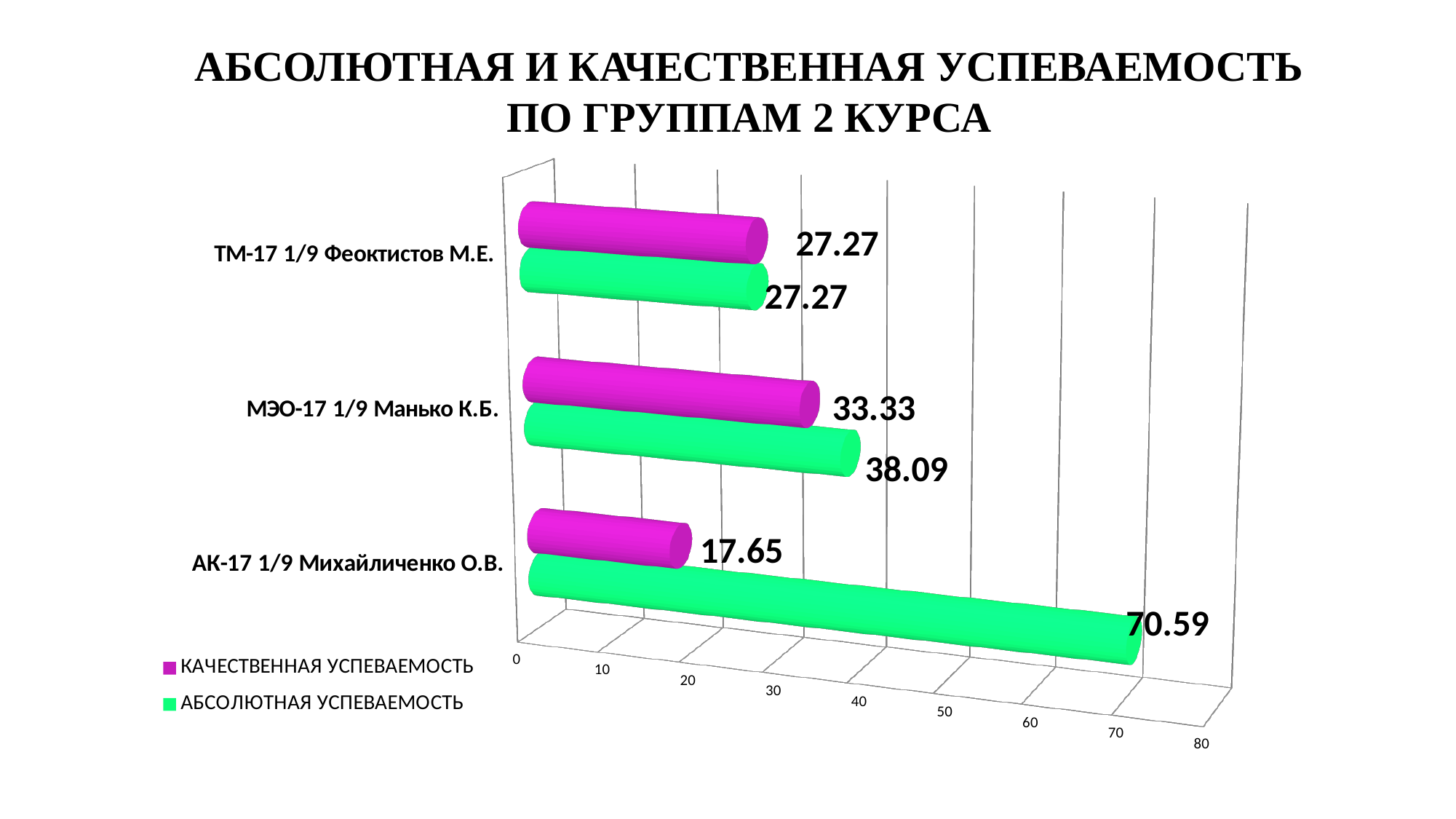
What is the difference between АБСОЛЮТНАЯ УСПЕВАЕМОСТЬ and КАЧЕСТВЕННАЯ УСПЕВАЕМОСТЬ for АК-17 1/9 Михайличенко О.В.? 52.94 How many series does the legend list? 2 Is the АБСОЛЮТНАЯ УСПЕВАЕМОСТЬ value for АК-17 1/9 Михайличенко О.В. greater or less than 60? greater What is the АБСОЛЮТНАЯ УСПЕВАЕМОСТЬ value for ТМ-17 1/9 Феоктистов М.Е.? 27.27 How many groups are shown on the chart? 3 What is the КАЧЕСТВЕННАЯ УСПЕВАЕМОСТЬ value for АК-17 1/9 Михайличенко О.В.? 17.65 Which is larger for МЭО-17 1/9 Манько К.Б.: АБСОЛЮТНАЯ УСПЕВАЕМОСТЬ or КАЧЕСТВЕННАЯ УСПЕВАЕМОСТЬ? АБСОЛЮТНАЯ УСПЕВАЕМОСТЬ Which group has the highest АБСОЛЮТНАЯ УСПЕВАЕМОСТЬ? АК-17 1/9 Михайличенко О.В. What is the АБСОЛЮТНАЯ УСПЕВАЕМОСТЬ value for АК-17 1/9 Михайличенко О.В.? 70.59 What is the КАЧЕСТВЕННАЯ УСПЕВАЕМОСТЬ value for МЭО-17 1/9 Манько К.Б.? 33.33 What kind of chart is shown on the slide? bar chart Which group has the lowest КАЧЕСТВЕННАЯ УСПЕВАЕМОСТЬ? АК-17 1/9 Михайличенко О.В.